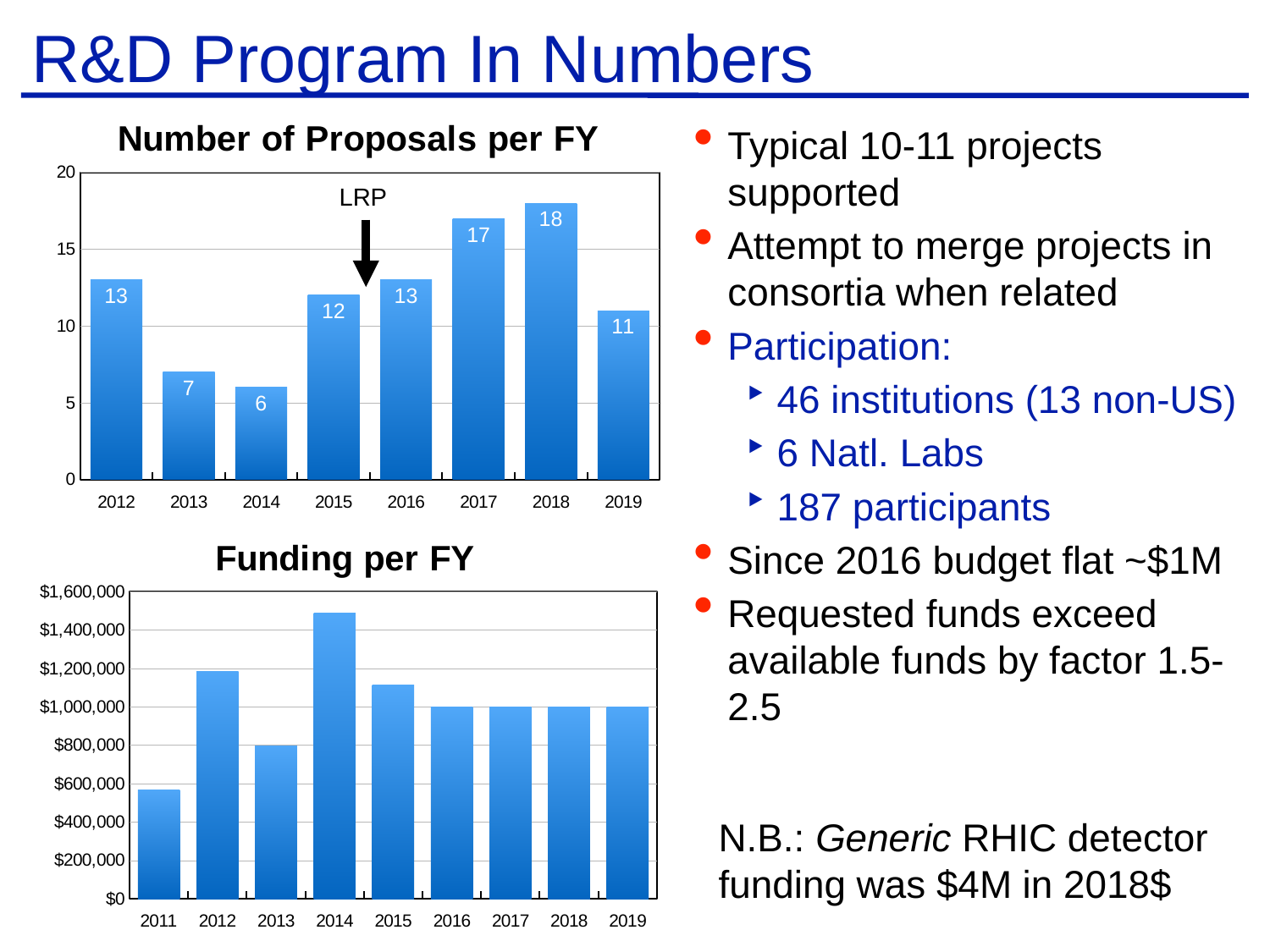
In the Number of Proposals per FY chart, which year had the lowest number of proposals? 2014 In the Number of Proposals per FY chart, how many proposals were there in 2014? 6 In the Number of Proposals per FY chart, which year had more proposals, 2015 or 2019? 2015 In the Number of Proposals per FY chart, how many proposals were there in 2018? 18 What kind of chart is the Funding per FY chart? Bar chart In the Funding per FY chart, which year had the highest funding? 2014 In the Funding per FY chart, is the value for 2013 greater or less than $1,000,000? less In the Number of Proposals per FY chart, which year had the highest number of proposals? 2018 In the Funding per FY chart, which year had the lowest funding? 2011 In the Funding per FY chart, is the value for 2012 greater or less than $1,000,000? greater In the Number of Proposals per FY chart, how many years are shown on the x axis? 8 In the Number of Proposals per FY chart, what is the difference between the number of proposals in 2017 and in 2013? 10